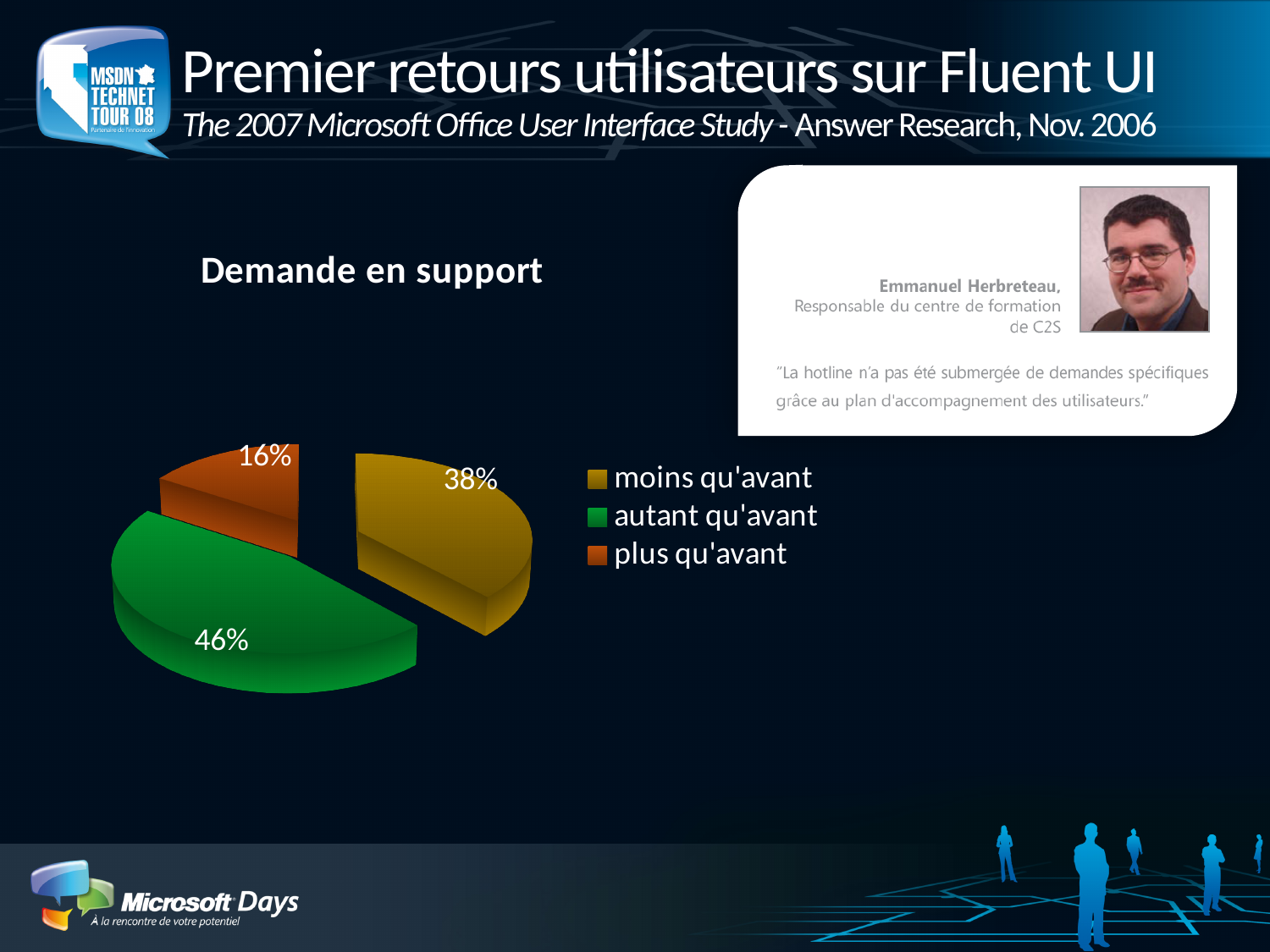
What colour is the slice for "autant qu'avant"? green Which category has the largest slice of the pie? autant qu'avant What is the difference in percentage points between "autant qu'avant" and "moins qu'avant"? 8 What is the difference in percentage points between "moins qu'avant" and "plus qu'avant"? 22 What share of the pie does "plus qu'avant" represent? 16% How many slices does the pie chart have? 3 Which category has the smallest slice of the pie? plus qu'avant Which is larger: the slice for "moins qu'avant" or the slice for "plus qu'avant"? moins qu'avant What kind of chart is shown under the heading "Demande en support"? pie chart How many entries does the legend of the pie chart list? 3 What share of the pie does "autant qu'avant" represent? 46% What share of the pie does "moins qu'avant" represent? 38%